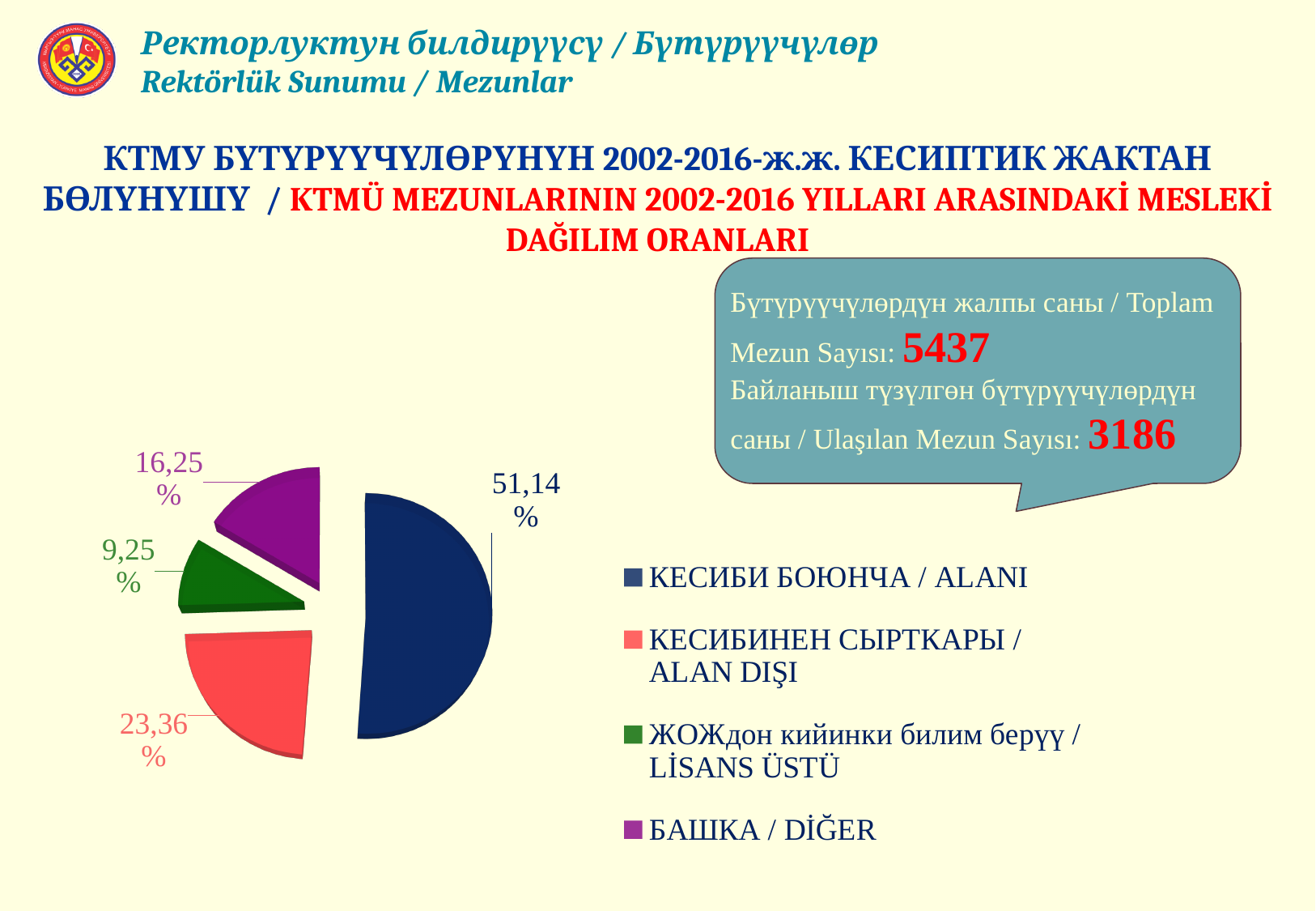
What share of the pie does КЕСИБИ БОЮНЧА / ALANI have? 51,14% What share of the pie does БАШКА / DİĞER have? 16,25% What share of the pie does КЕСИБИНЕН СЫРТКАРЫ / ALAN DIŞI have? 23,36% How many entries does the legend list? 4 Which slice is larger: БАШКА / DİĞER or ЖОЖдон кийинки билим берүү / LİSANS ÜSTÜ? БАШКА / DİĞER How many slices does the pie chart have? 4 What is the difference in percentage points between the КЕСИБИ БОЮНЧА / ALANI slice and the КЕСИБИНЕН СЫРТКАРЫ / ALAN DIŞI slice? 27,78 What colour is the slice for БАШКА / DİĞER? purple Which category has the largest slice of the pie? КЕСИБИ БОЮНЧА / ALANI Which category has the smallest slice of the pie? ЖОЖдон кийинки билим берүү / LİSANS ÜSTÜ What kind of chart is shown on the slide? pie chart